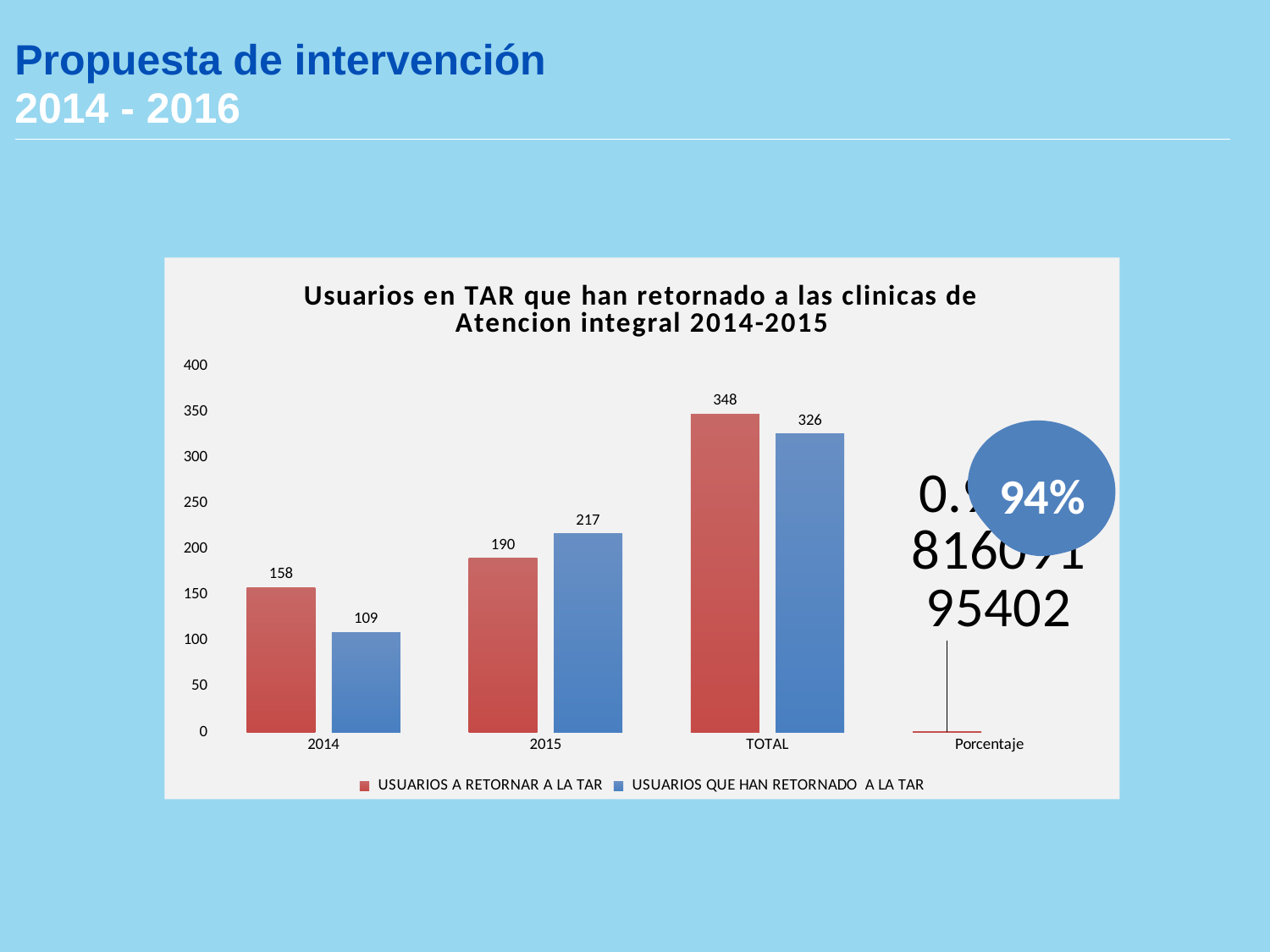
What kind of chart is shown on the slide? bar chart What is the value for USUARIOS QUE HAN RETORNADO A LA TAR in 2014? 109 What is the value for USUARIOS A RETORNAR A LA TAR in 2014? 158 What is the value for USUARIOS QUE HAN RETORNADO A LA TAR in 2015? 217 What percentage is shown in the blue circle on the chart? 94% What is the value for USUARIOS A RETORNAR A LA TAR in 2015? 190 How many series does the legend list? 2 What is the difference between the TOTAL values of USUARIOS A RETORNAR A LA TAR and USUARIOS QUE HAN RETORNADO A LA TAR? 22 What is the TOTAL value for USUARIOS A RETORNAR A LA TAR? 348 In 2015, which series has the larger value: USUARIOS A RETORNAR A LA TAR or USUARIOS QUE HAN RETORNADO A LA TAR? USUARIOS QUE HAN RETORNADO A LA TAR Is the value for USUARIOS QUE HAN RETORNADO A LA TAR in 2014 greater or less than 150? less What is the TOTAL value for USUARIOS QUE HAN RETORNADO A LA TAR? 326